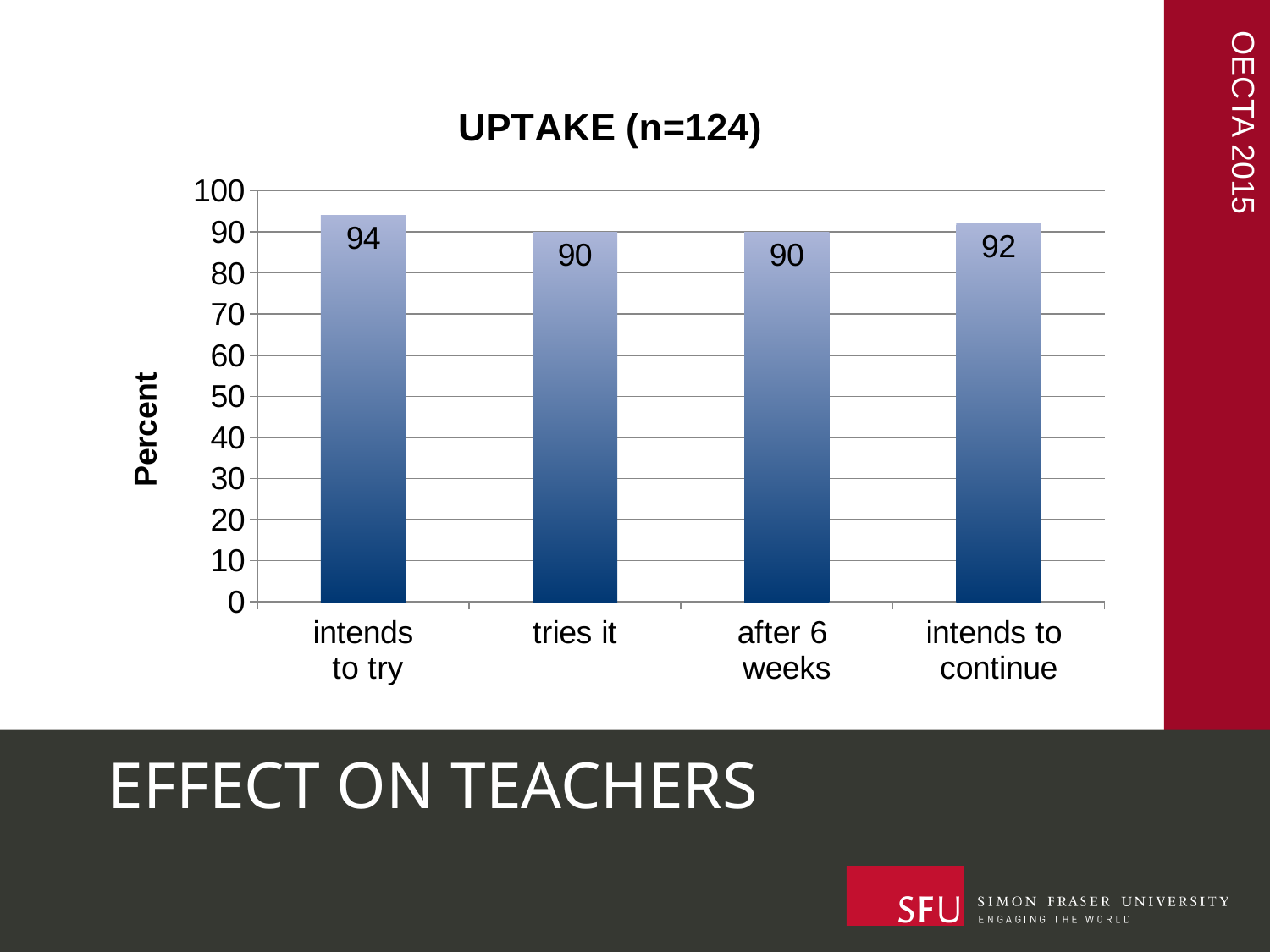
Which category has the highest value? intends to try Which is larger, the value for "intends to continue" or the value for "tries it"? intends to continue What is the value for "intends to continue"? 92 What is the label of the vertical axis? Percent What kind of chart is shown on the slide? bar chart What is the value for "intends to try"? 94 What is the difference between the values for "intends to try" and "intends to continue"? 2 What is the difference between the values for "intends to try" and "after 6 weeks"? 4 What is the title of the chart? UPTAKE (n=124) What is the value for "tries it"? 90 How many categories are shown on the x axis? 4 Is the value for "after 6 weeks" greater or less than 50? greater